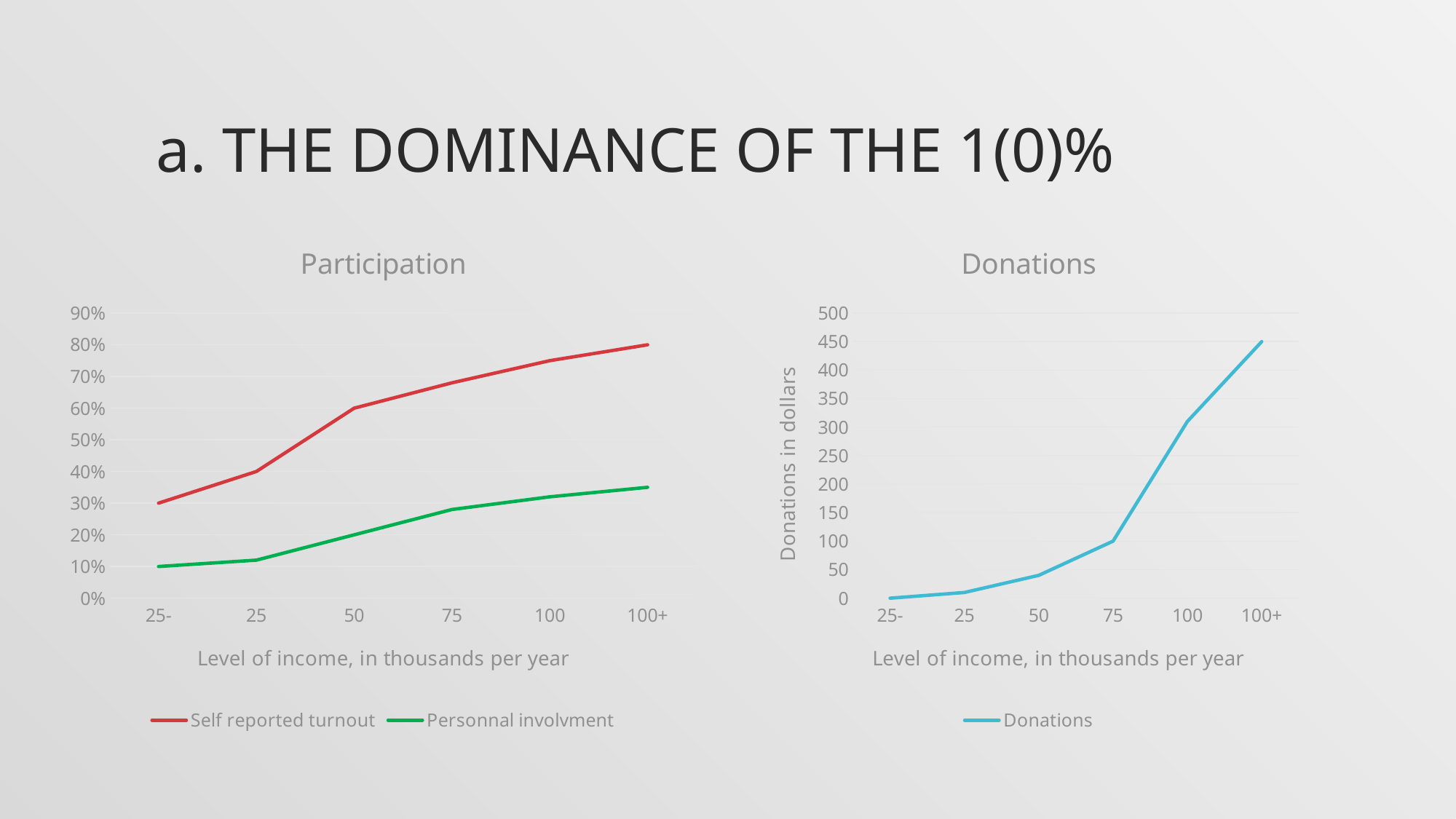
How many income levels are shown on the x axis of the Donations chart? 6 In the Donations chart, what is the donations value at the 100+ income level? 450 In the Participation chart, what is the difference between Self reported turnout at 100+ and at 25-? 50% In the Participation chart, what is the Personnal involvment value at the 25- income level? 10% In the Donations chart, do donations rise or fall as the level of income increases? rise In the Donations chart, at which income level are donations highest? 100+ How many series does the legend of the Participation chart list? 2 In the Participation chart, is the Personnal involvment value at the 100+ income level greater or less than 40%? less In the Participation chart, what is the Self reported turnout value at the 100+ income level? 80% In the Participation chart, which series is higher at the 75 income level, Self reported turnout or Personnal involvment? Self reported turnout In the Participation chart, what is the Self reported turnout value at the 50 income level? 60% What type of chart is the Participation chart? line chart